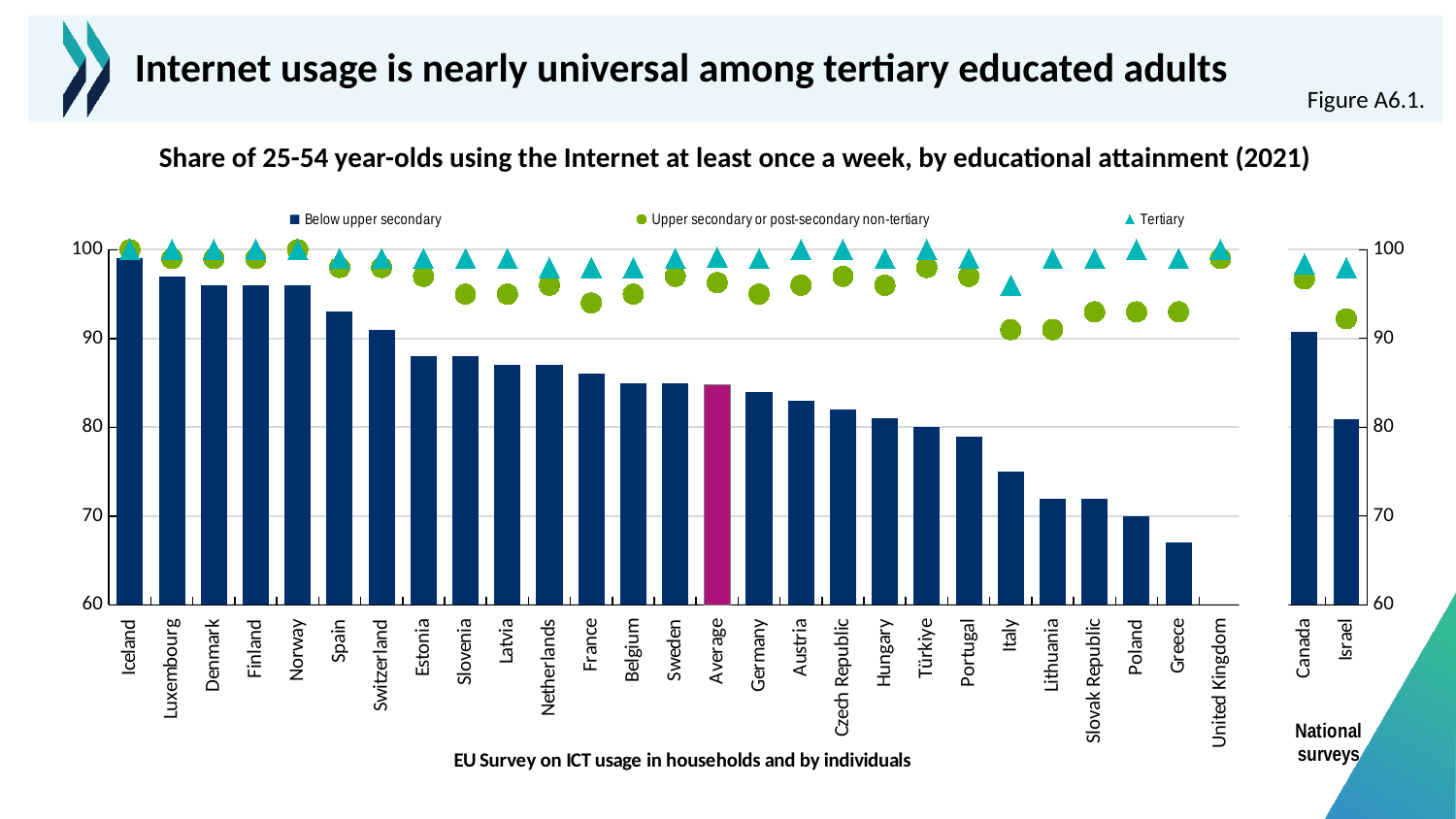
How many countries are shown in the 'National surveys' panel? 2 Is the 'Below upper secondary' value for Greece greater or less than 70? less Which category's bar is highlighted in a different colour (magenta) from the other bars? Average Is the 'Below upper secondary' value for Israel greater or less than 90? less What kind of chart is shown on the slide? bar chart with markers Which has the larger 'Below upper secondary' value, Spain or Italy? Spain Which country has the highest bar for 'Below upper secondary' in the EU Survey panel? Iceland Is the 'Below upper secondary' value for Italy greater or less than 80? less Which country has the lowest bar for 'Below upper secondary' in the EU Survey panel? Greece How many series does the legend list? 3 Do the 'Below upper secondary' bars rise or fall from left to right across the EU Survey panel? fall